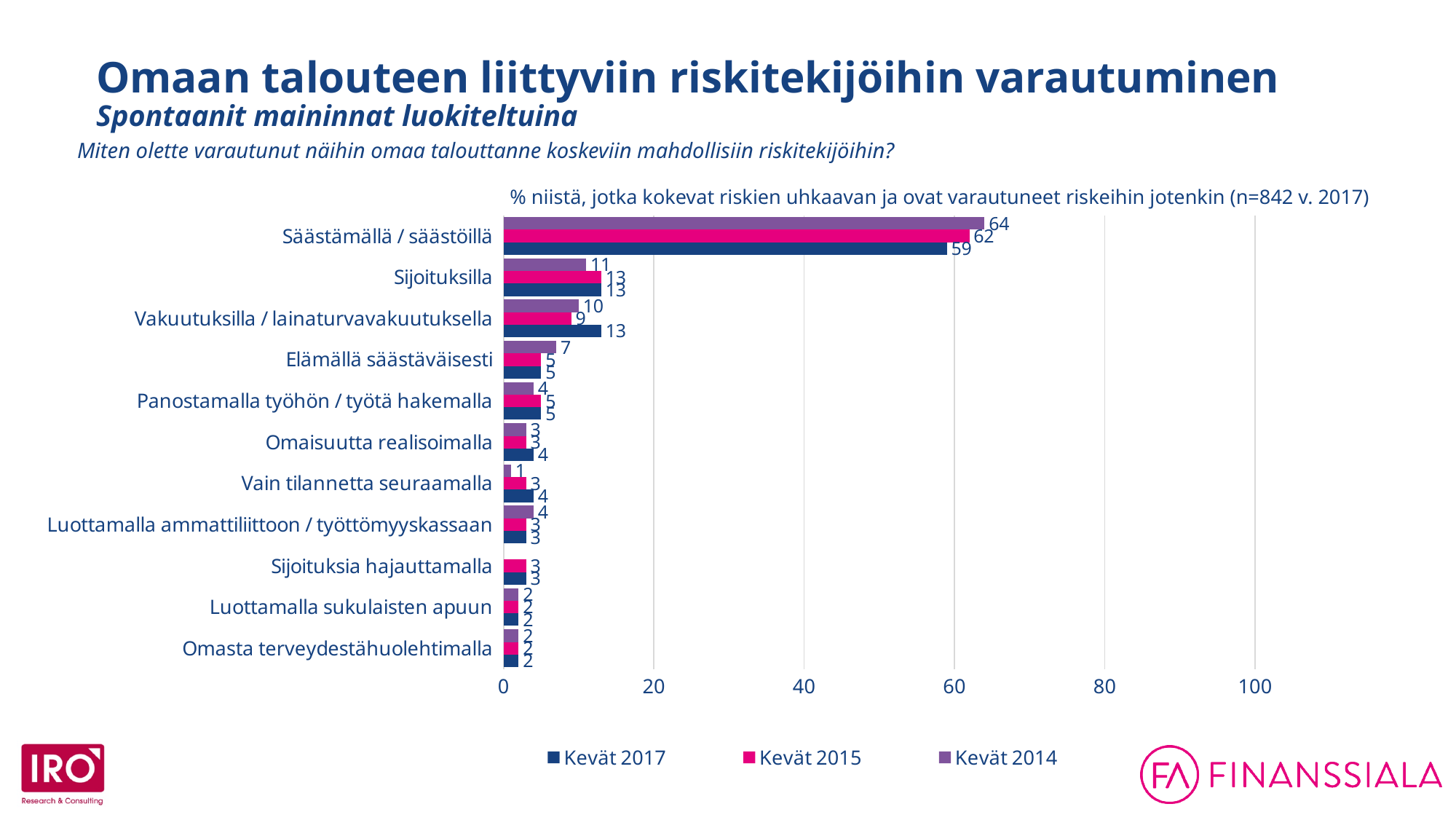
How many categories are shown on the chart? 11 What is the Kevät 2017 value for Säästämällä / säästöillä? 59 Which is larger for Vakuutuksilla / lainaturvavakuutuksella: the Kevät 2017 value or the Kevät 2015 value? Kevät 2017 How many series does the legend list? 3 Which series is shown in pink in the legend? Kevät 2015 Is the Kevät 2015 value for Säästämällä / säästöillä greater or less than 60? greater What is the difference between the Kevät 2014 and Kevät 2017 values for Säästämällä / säästöillä? 5 What is the Kevät 2017 value for Vain tilannetta seuraamalla? 4 What is the Kevät 2015 value for Vakuutuksilla / lainaturvavakuutuksella? 9 Which category has the highest Kevät 2017 value? Säästämällä / säästöillä What is the Kevät 2014 value for Säästämällä / säästöillä? 64 What kind of chart is shown on the slide? Bar chart